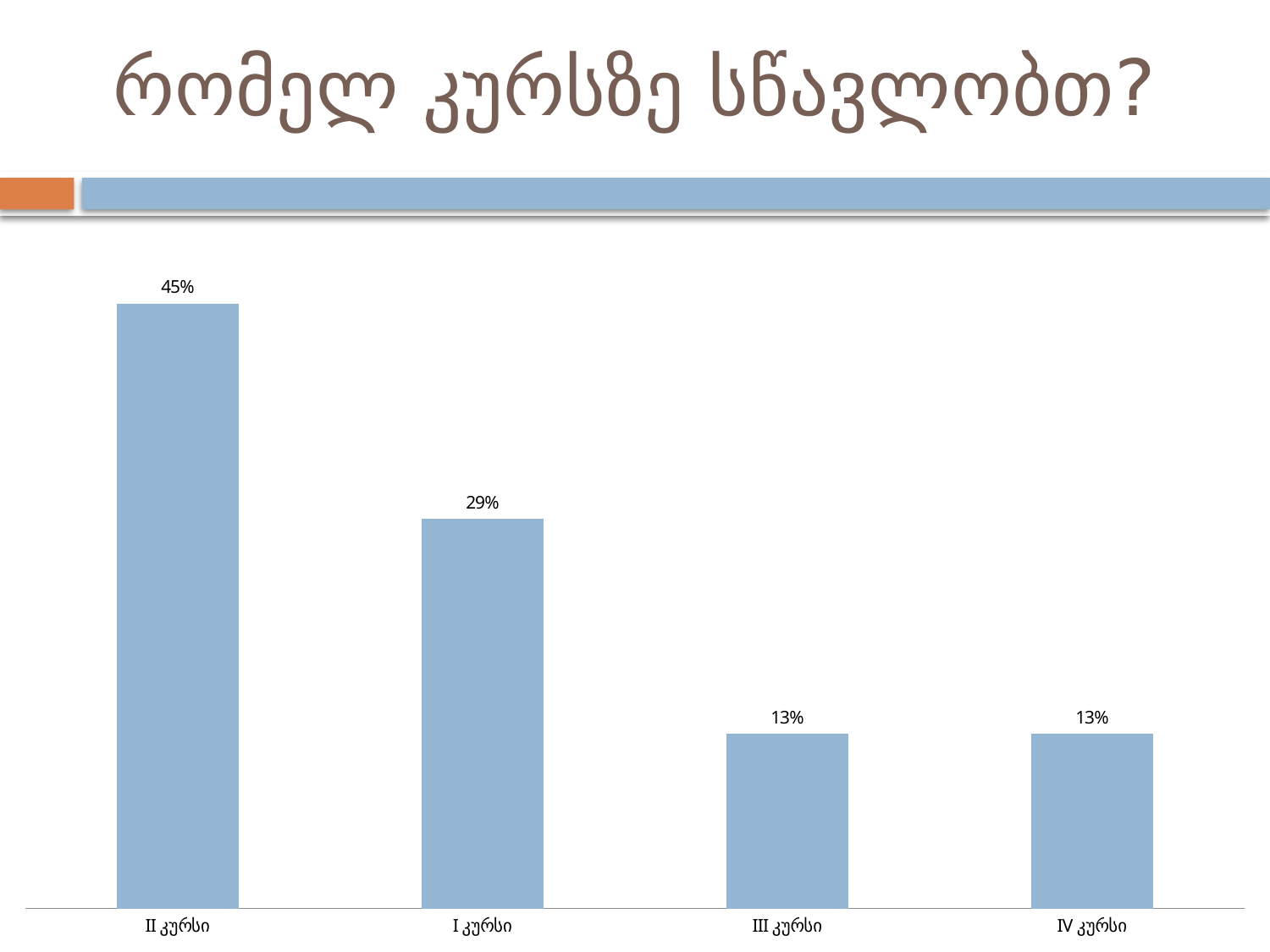
What is the value for II კურსი? 45% Which category has the highest value? II კურსი What is the difference between the values for I კურსი and III კურსი? 16% Which is larger, the value for II კურსი or the value for III კურსი? II კურსი What kind of chart is shown on the slide? Bar chart What is the value for IV კურსი? 13% How many categories are shown on the chart? 4 What is the value for III კურსი? 13% What is the value for I კურსი? 29% What is the title of the slide? რომელ კურსზე სწავლობთ? What is the difference between the values for II კურსი and I კურსი? 16% Which is larger, the value for I კურსი or the value for IV კურსი? I კურსი